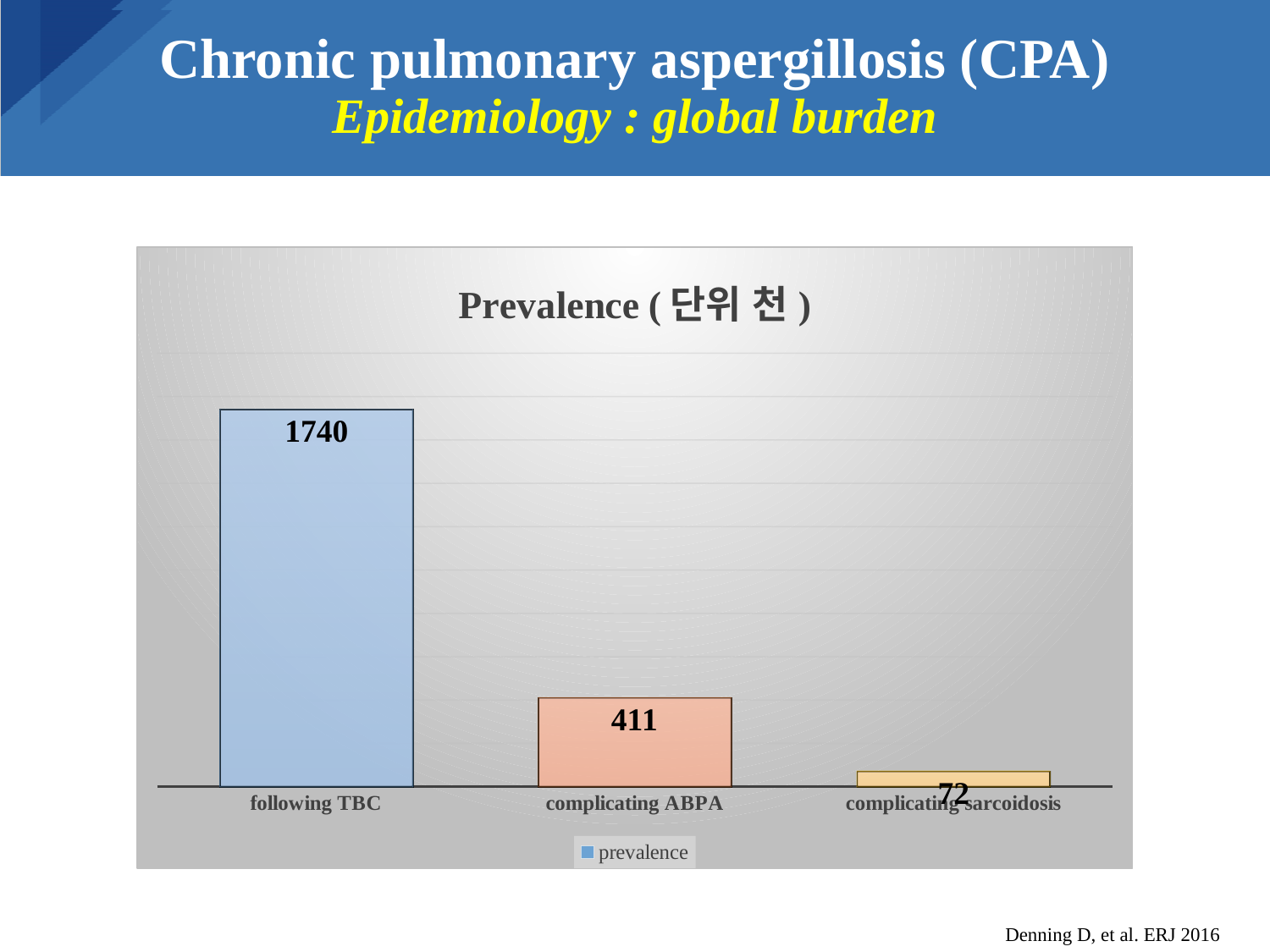
Which category has the lowest prevalence? complicating sarcoidosis What is the difference between the prevalence for 'complicating ABPA' and 'complicating sarcoidosis'? 339 What is the prevalence value for 'complicating ABPA'? 411 How many series does the legend list? 1 How many categories are shown in the chart? 3 What is the difference between the prevalence for 'following TBC' and 'complicating ABPA'? 1329 What kind of chart is shown on the slide? bar chart Which category has the highest prevalence? following TBC What is the prevalence value for 'complicating sarcoidosis'? 72 What is the name of the series shown in the legend? prevalence What is the prevalence value for 'following TBC'? 1740 Which is larger, the prevalence for 'complicating ABPA' or for 'complicating sarcoidosis'? complicating ABPA